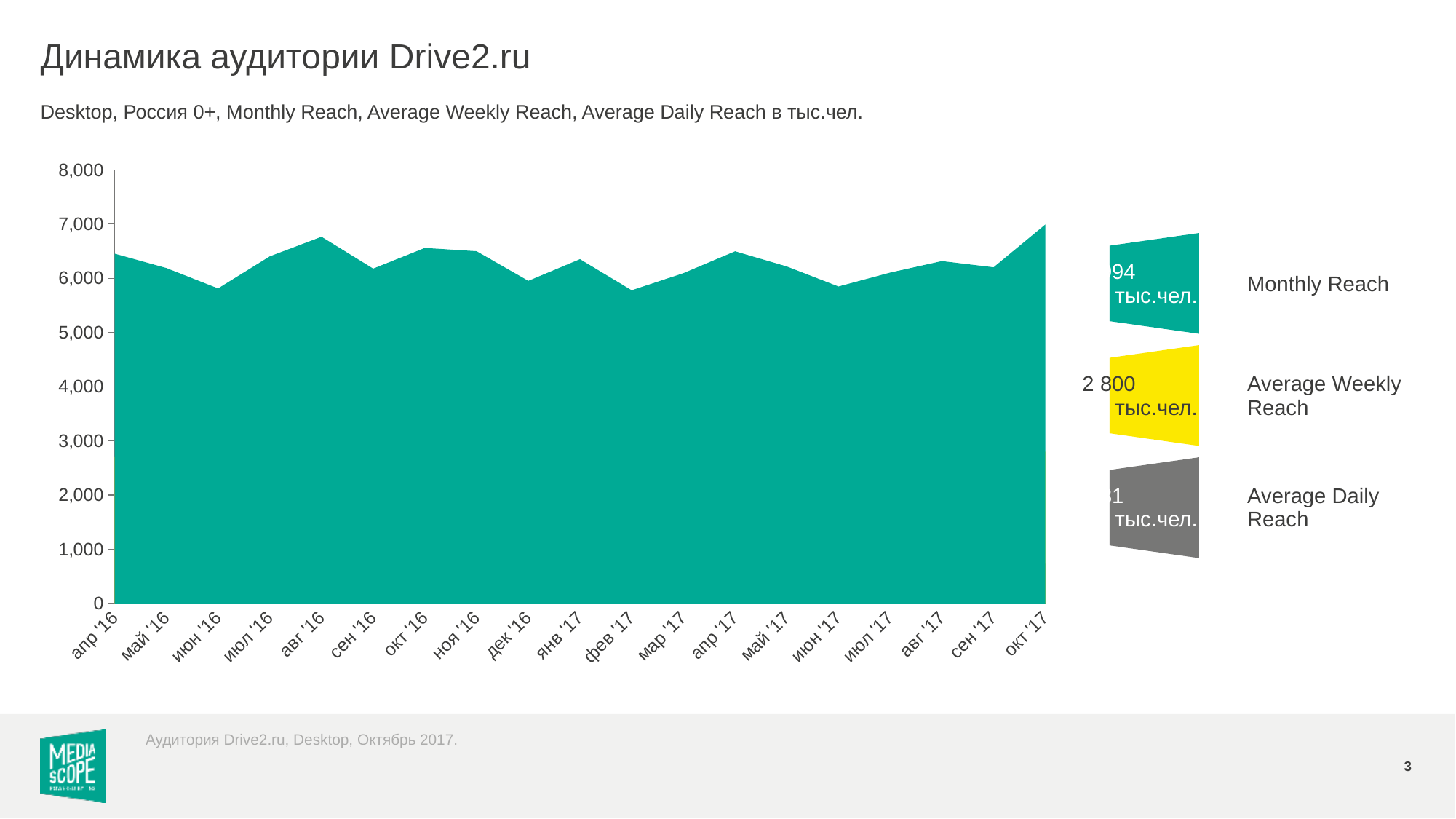
Does the value rise or fall from сен '17 to окт '17? rise How many months are plotted along the x axis of the chart? 19 Is the value for авг '16 greater or less than 6,500? greater What is the title of the slide containing the chart? Динамика аудитории Drive2.ru Which is larger, the value for авг '16 or the value for июн '16? авг '16 Is the value for окт '17 greater or less than 6,000? greater Is the value for авг '16 greater or less than 7,000? less Which is larger, the value for окт '17 or the value for сен '17? окт '17 What kind of chart is shown on the slide? area chart What is the highest tick value shown on the y axis of the chart? 8,000 Which month has the highest Monthly Reach value in the chart? окт '17